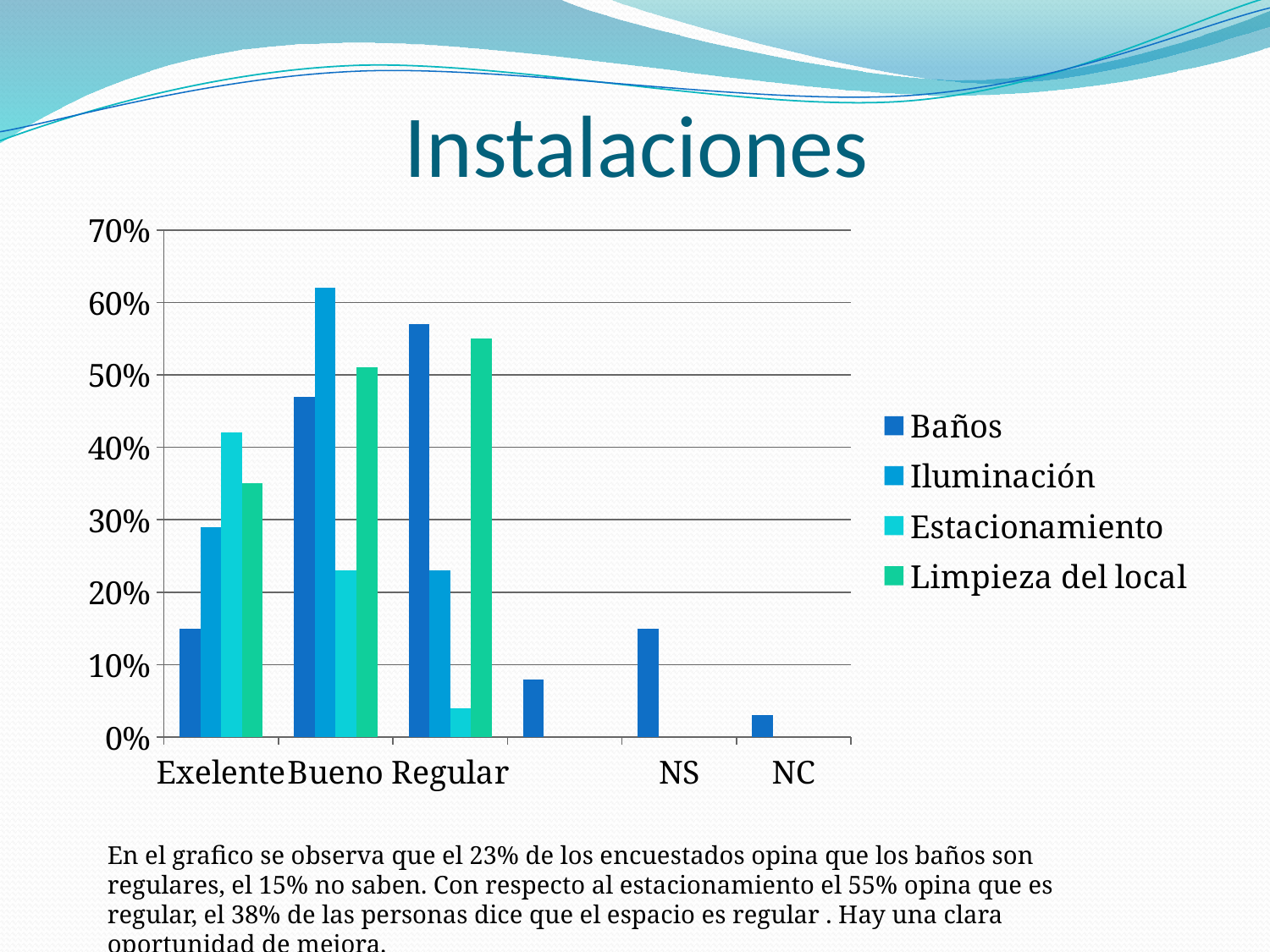
Is the value for Estacionamiento at Regular greater or less than 10%? less What kind of chart is shown on the slide? bar chart Which series has the highest value for Exelente? Estacionamiento What is the title of the chart? Instalaciones For Baños, which is larger: the value for Regular or the value for Bueno? Regular Which series has the highest value for Bueno? Iluminación Which series has the lowest value for Regular? Estacionamiento How many series does the legend list? 4 Is the value for Baños at NC greater or less than 10%? less Is the value for Baños at Exelente greater or less than 20%? less For Iluminación, which is larger: the value for Bueno or the value for Regular? Bueno